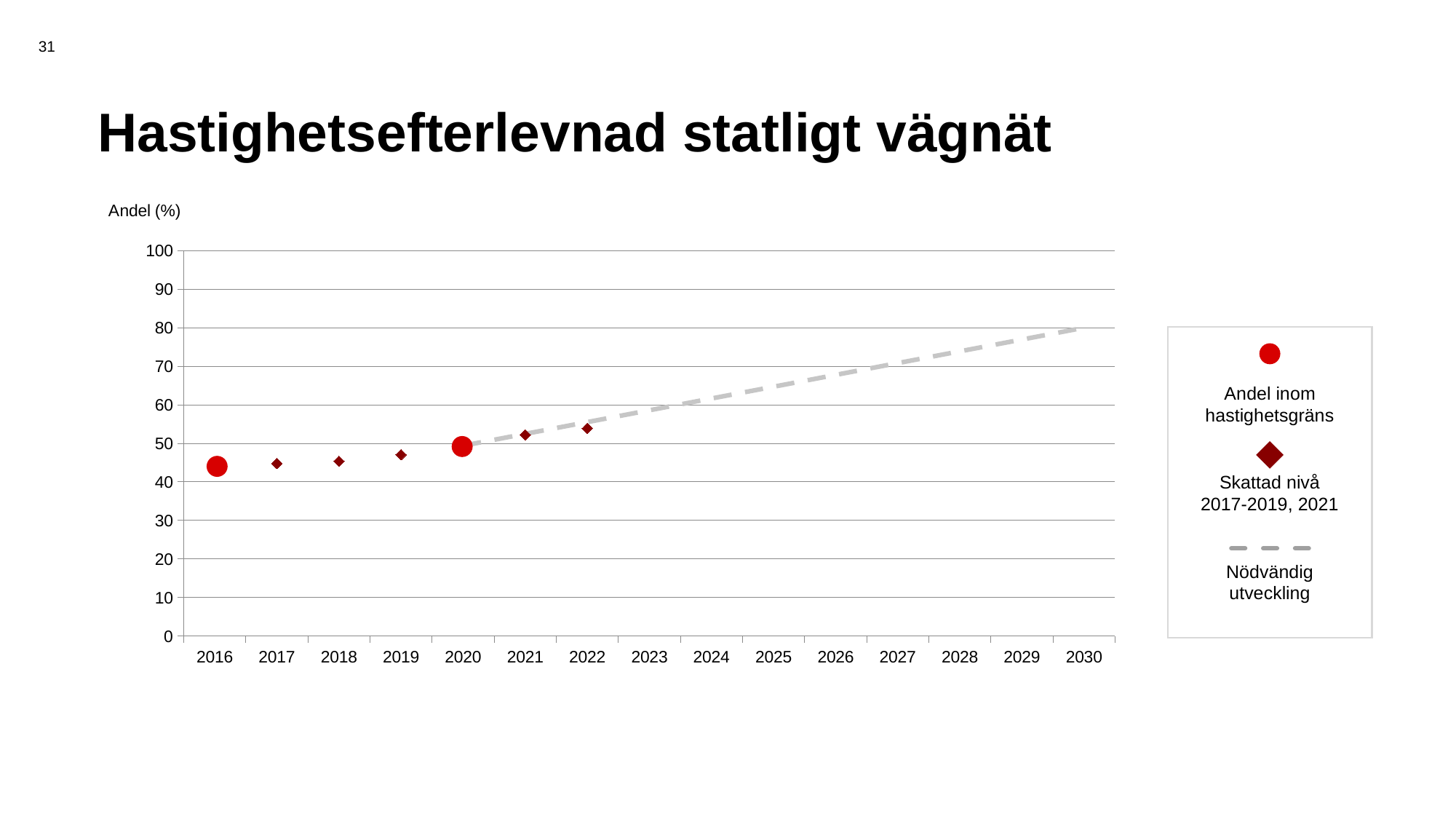
Which legend entry is shown with a grey dashed line? Nödvändig utveckling Is the value for 2022 (Skattad nivå) greater or less than 50? greater How many years are labelled on the x axis? 15 Is the value of the Nödvändig utveckling line at 2030 greater or less than 70? greater What kind of chart is shown on the slide? line chart How many series does the legend list? 3 How many red circle points (Andel inom hastighetsgräns) are plotted? 2 What is the label of the y axis? Andel (%) Does the Nödvändig utveckling dashed line rise or fall from 2020 to 2030? rise Is the value for 2017 (Skattad nivå) greater or less than 50? less How many diamond points (Skattad nivå) are plotted? 5